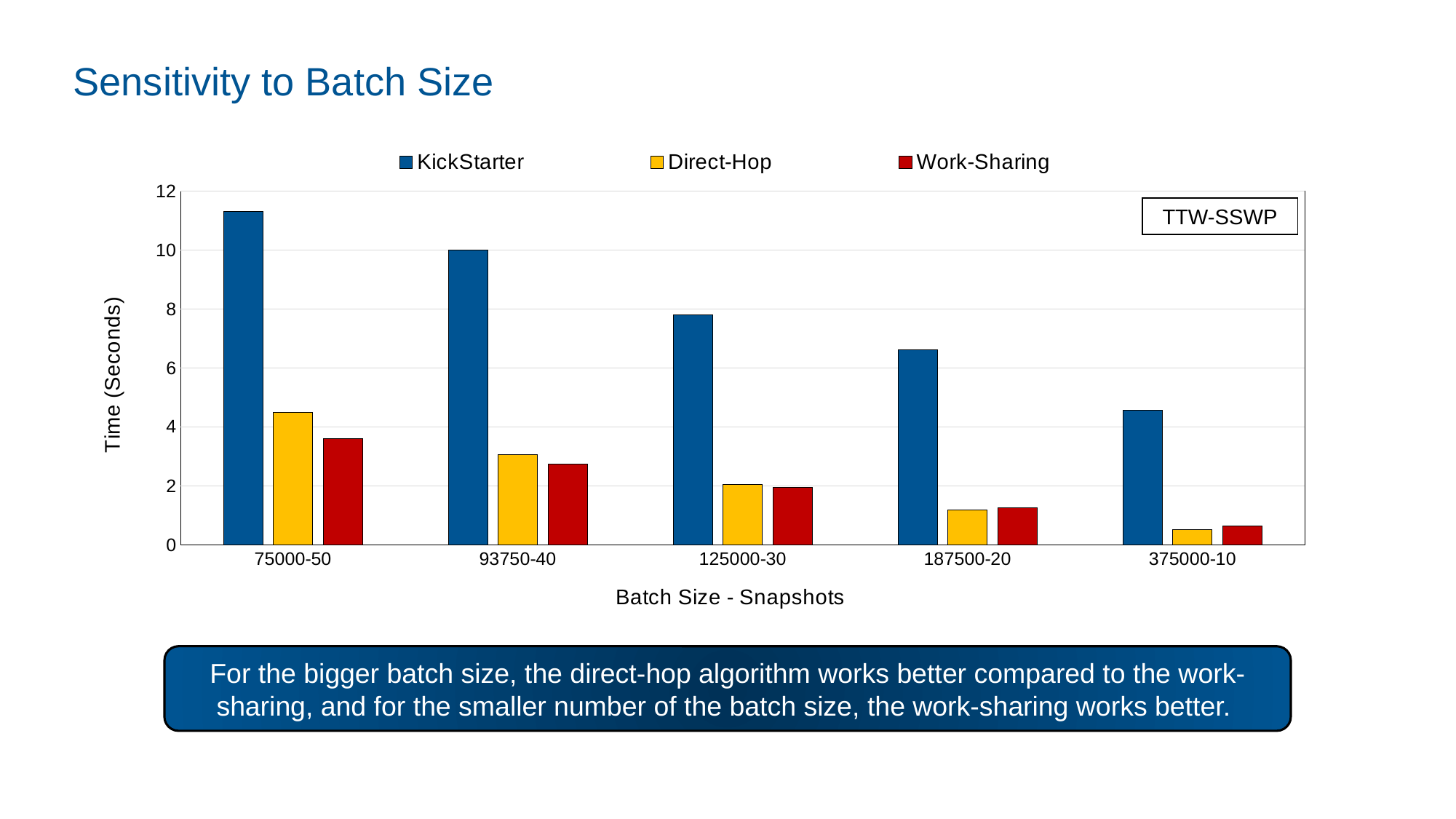
What is the label on the y axis? Time (Seconds) Do the KickStarter values rise or fall from 75000-50 to 375000-10? fall What text appears in the box in the upper right corner of the chart? TTW-SSWP For which batch size is the KickStarter bar highest? 75000-50 At batch size 75000-50, which is larger: Direct-Hop or Work-Sharing? Direct-Hop For which batch size is the Direct-Hop bar lowest? 375000-10 Is the KickStarter value for 125000-30 greater or less than 8? less How many series does the legend list? 3 How many batch size categories are shown on the x axis? 5 What kind of chart is shown on the slide? bar chart Is the Work-Sharing value for 375000-10 greater or less than 2? less Is the KickStarter value for 75000-50 greater or less than 10? greater